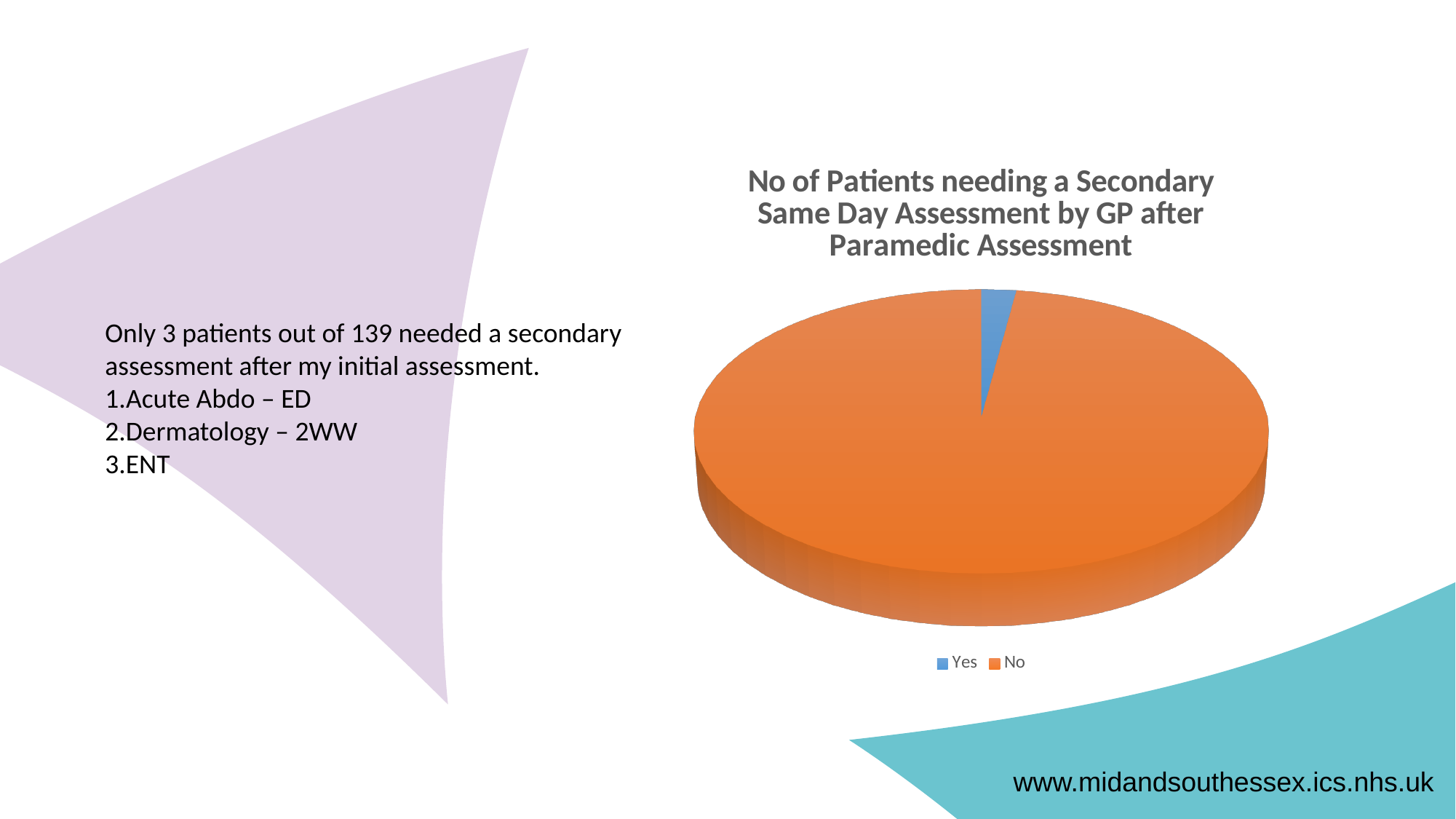
Which category has the largest slice in the pie chart? No Which category has the smallest slice in the pie chart? Yes How many slices does the pie chart have? 2 Which slice is larger in the pie chart, Yes or No? No How many entries does the legend of the pie chart list? 2 What colour is the 'Yes' slice in the pie chart? Blue What kind of chart is shown on the slide? Pie chart What is the title of the pie chart? No of Patients needing a Secondary Same Day Assessment by GP after Paramedic Assessment